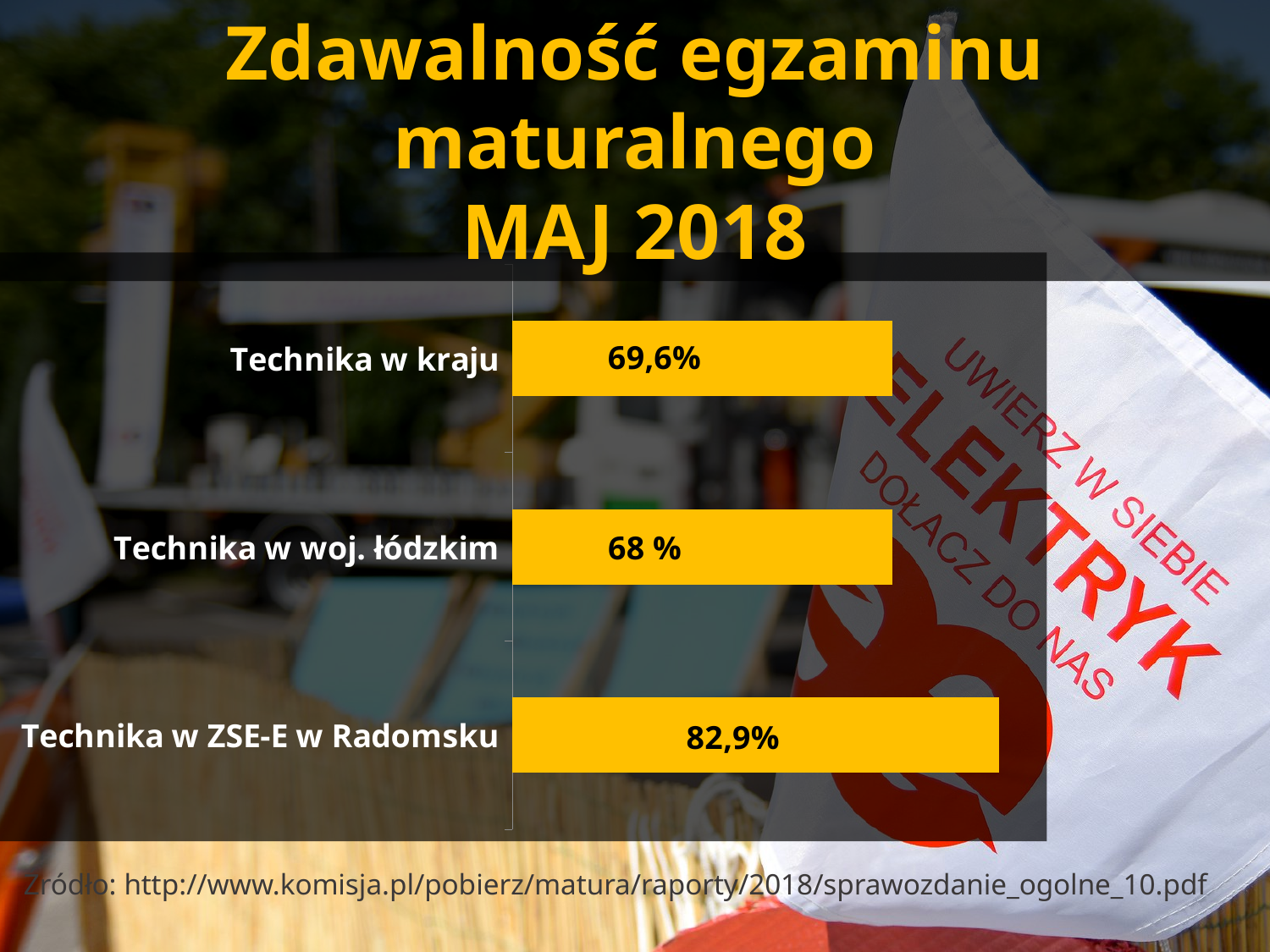
By how many percentage points does Technika w ZSE-E w Radomsku exceed Technika w kraju? 13,3 Which is larger: the pass rate for Technika w kraju or for Technika w woj. łódzkim? Technika w kraju By how many percentage points does Technika w kraju exceed Technika w woj. łódzkim? 1,6 What is the title of the slide containing the chart? Zdawalność egzaminu maturalnego MAJ 2018 What is the pass rate shown for Technika w ZSE-E w Radomsku? 82,9% What colour are the bars in the chart? Yellow What is the pass rate shown for Technika w woj. łódzkim? 68 % How many categories are shown in the chart? 3 Which category has the highest pass rate? Technika w ZSE-E w Radomsku What kind of chart is shown on the slide? Bar chart Which category has the lowest pass rate? Technika w woj. łódzkim What is the pass rate shown for Technika w kraju? 69,6%